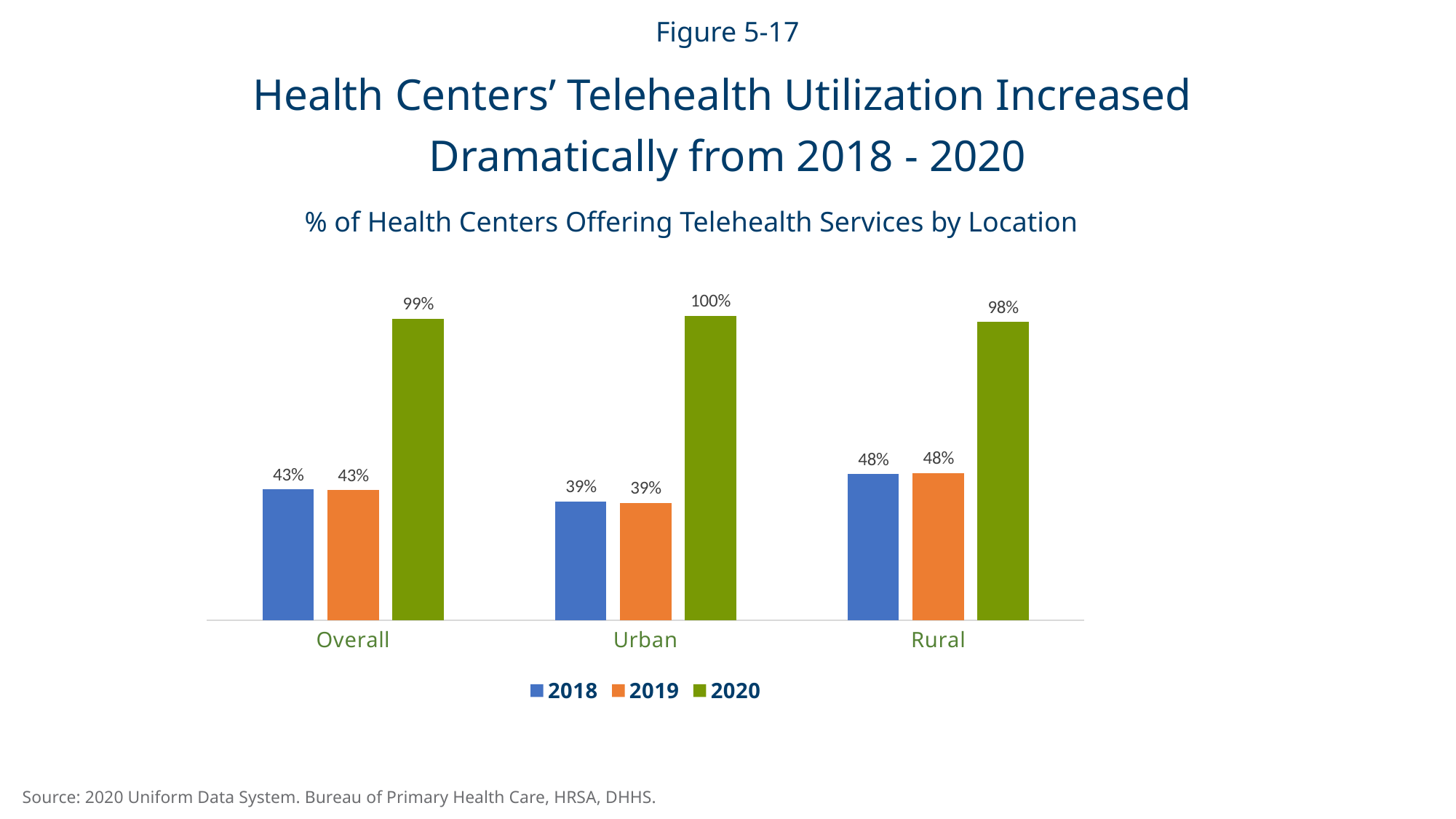
For Urban, do the values rise or fall from 2019 to 2020? Rise What is the value for Rural in 2018? 48% How many location categories are shown on the x axis? 3 Which is larger, the 2018 value for Rural or the 2018 value for Overall? Rural What is the difference between the Rural 2020 value and the Rural 2019 value? 50% Which location has the lowest value for 2018? Urban What is the Overall value for 2019? 43% What kind of chart is shown on the slide? Bar chart Which colour represents the 2020 series in the legend? Green What percentage of Urban health centers offered telehealth services in 2020? 100% Which location has the highest value for 2020? Urban How many series does the legend list? 3